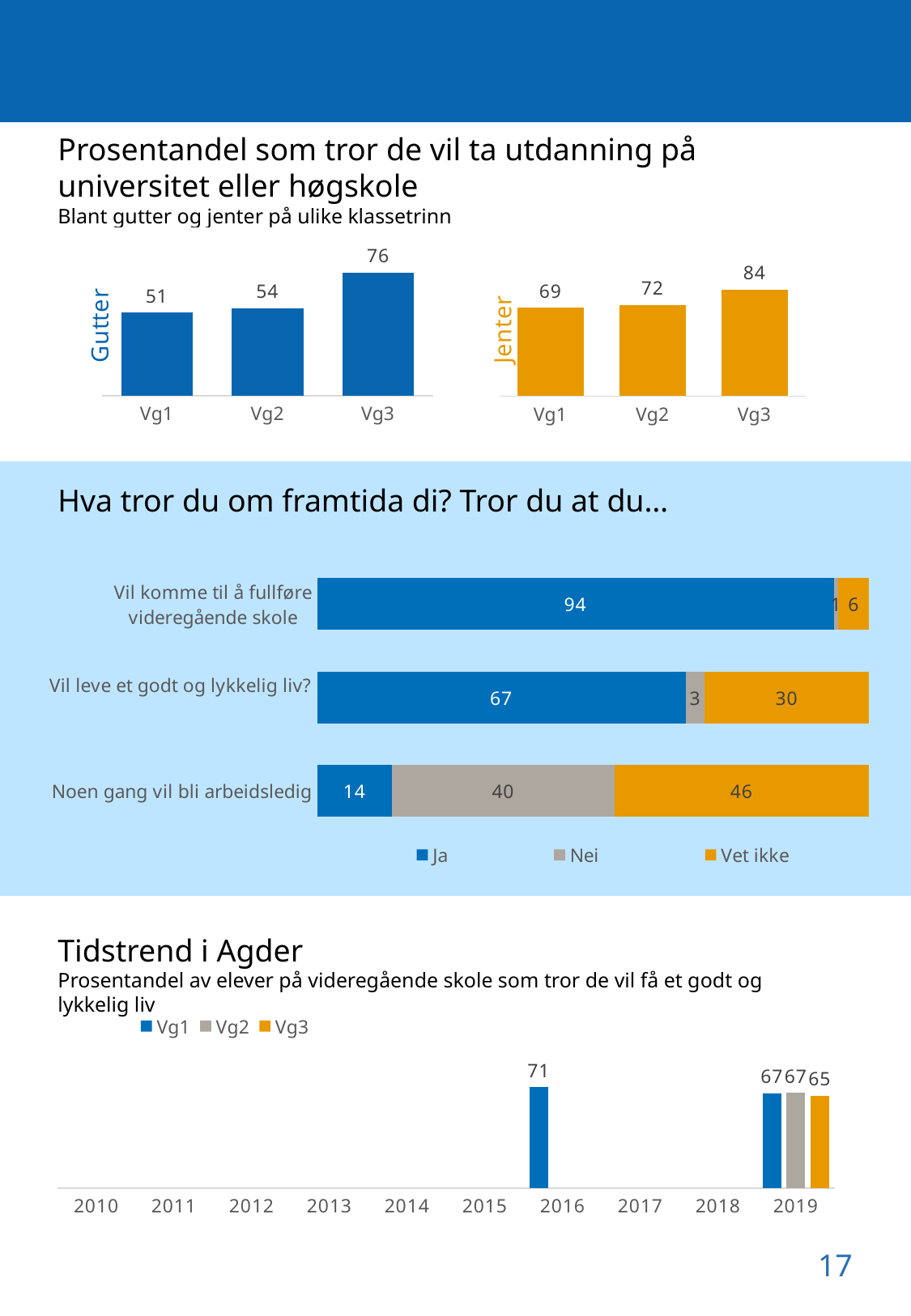
In the top chart 'Prosentandel som tror de vil ta utdanning på universitet eller høgskole', what is the value for Jenter in Vg1? 69 In the top chart 'Prosentandel som tror de vil ta utdanning på universitet eller høgskole', what is the value for Gutter in Vg3? 76 In the middle chart 'Hva tror du om framtida di? Tror du at du…', what is the 'Ja' value for 'Vil komme til å fullføre videregående skole'? 94 What kind of chart is the bottom chart 'Tidstrend i Agder'? bar chart In the middle chart 'Hva tror du om framtida di? Tror du at du…', what is the 'Vet ikke' value for 'Noen gang vil bli arbeidsledig'? 46 In the middle chart 'Hva tror du om framtida di? Tror du at du…', what is the total of the stacked bar for 'Vil leve et godt og lykkelig liv?'? 100 In the top chart 'Prosentandel som tror de vil ta utdanning på universitet eller høgskole', what is the difference between Jenter and Gutter in Vg2? 18 In the top chart 'Prosentandel som tror de vil ta utdanning på universitet eller høgskole', which class level has the highest value for Jenter? Vg3 In the middle chart 'Hva tror du om framtida di? Tror du at du…', how many series does the legend list? 3 In the bottom chart 'Tidstrend i Agder', what is the value for Vg3 in 2019? 65 In the bottom chart 'Tidstrend i Agder', what is the value for Vg1 in 2016? 71 In the top chart 'Prosentandel som tror de vil ta utdanning på universitet eller høgskole', do the values for Gutter rise or fall from Vg1 to Vg3? rise